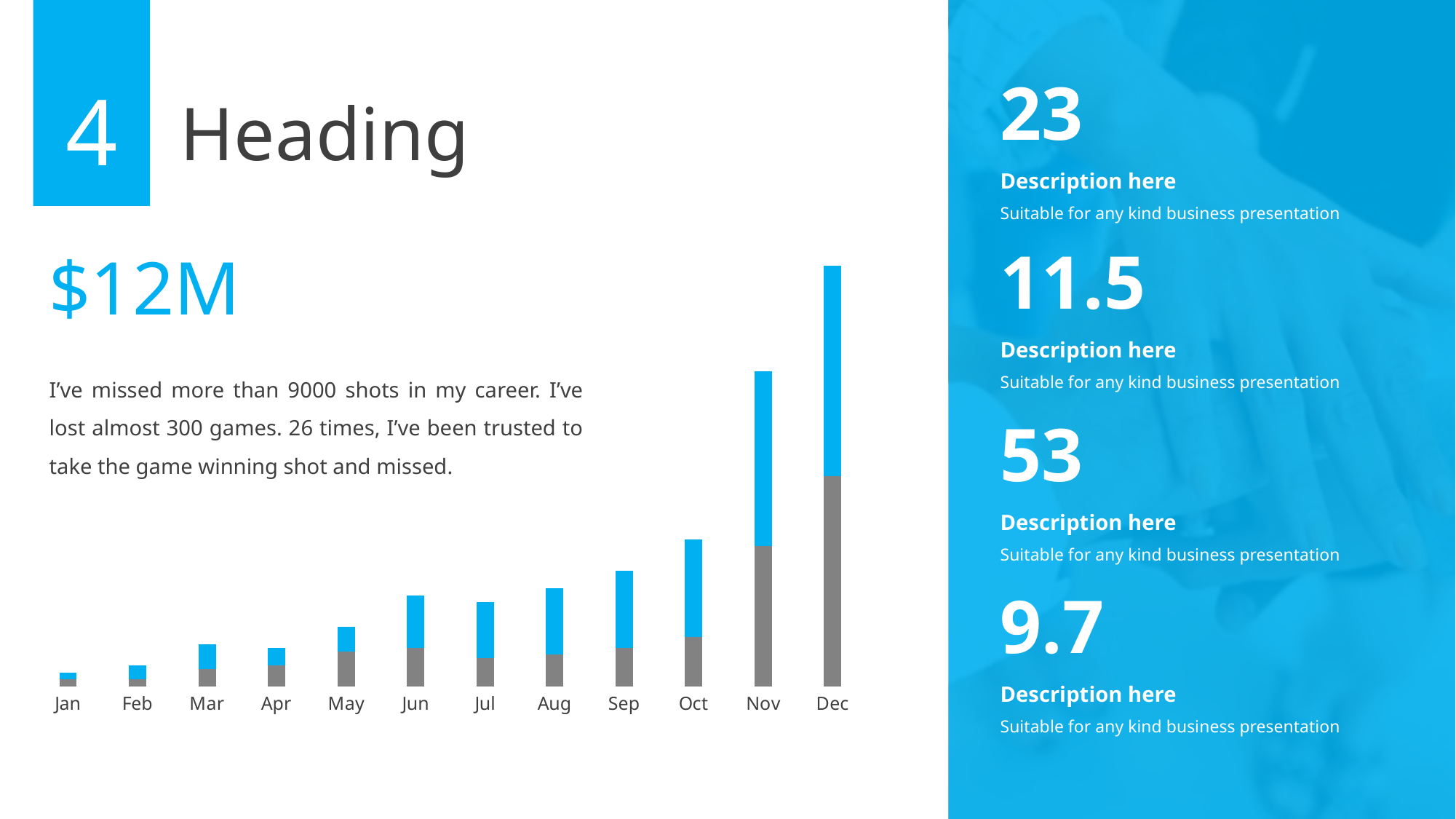
How many months are shown on the x axis of the chart? 12 Which month has the shortest bar in the chart? Jan Which bar is taller, Sep or Jun? Sep Which bar is taller, May or Aug? Aug Which bar is taller, Nov or Oct? Nov What two colours are used for the segments of the stacked bars? Blue and grey What kind of chart is shown on the slide? Stacked bar chart Which month has the tallest bar in the chart? Dec What is the first month shown on the x axis of the chart? Jan Do the bar heights generally rise or fall from Jan to Dec? Rise